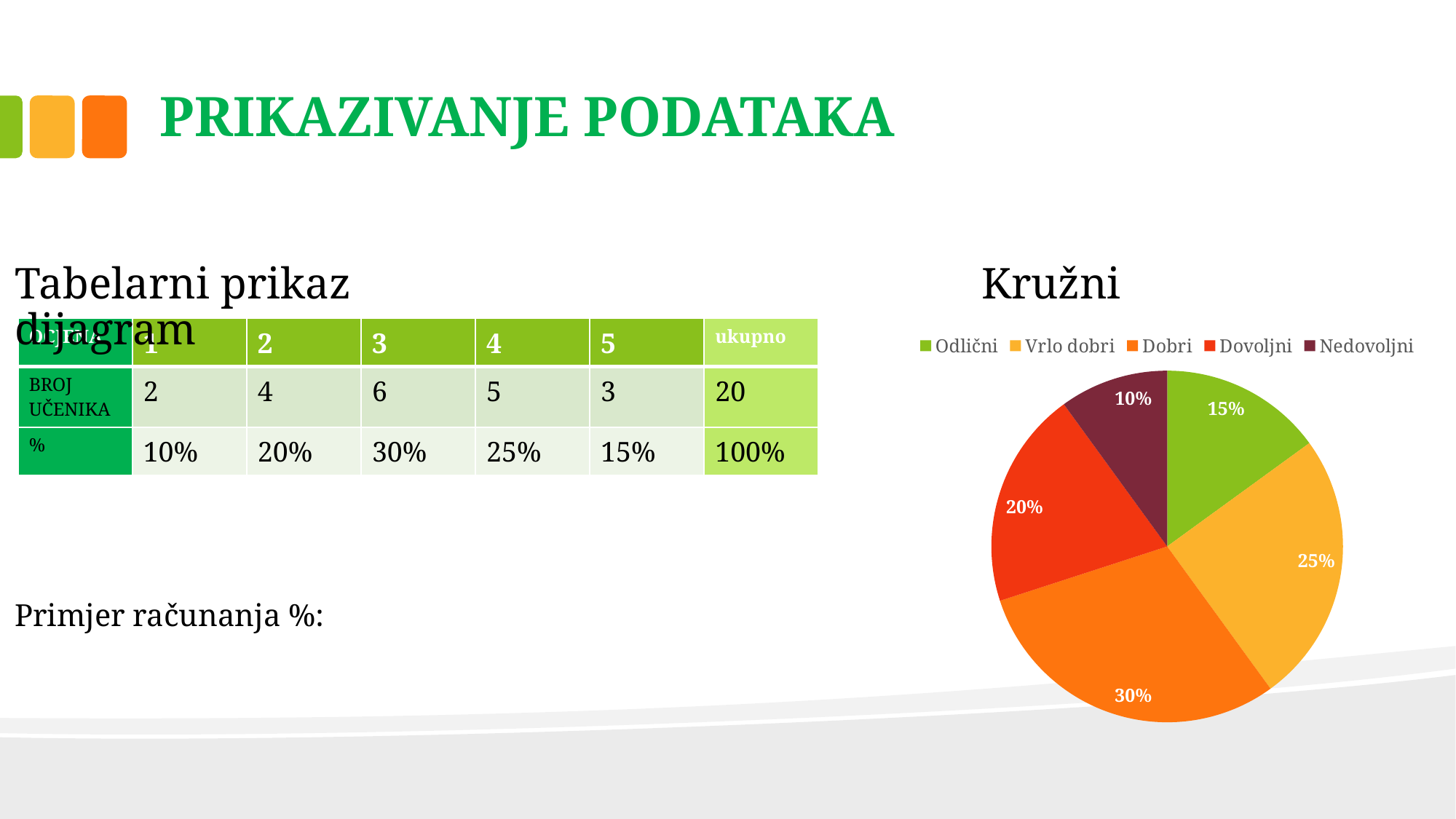
How many slices does the pie chart have? 5 Which slice is larger in the pie chart, Vrlo dobri or Dovoljni? Vrlo dobri What share of the pie chart does the Odlični slice represent? 15% What share of the pie chart does the Nedovoljni slice represent? 10% Which category has the largest slice in the pie chart? Dobri What colour is the Nedovoljni slice in the pie chart? dark red What is the difference in percentage points between the Dobri and Odlični slices? 15% What kind of chart is shown on the slide? pie chart Which category has the smallest slice in the pie chart? Nedovoljni What share of the pie chart does the Vrlo dobri slice represent? 25%